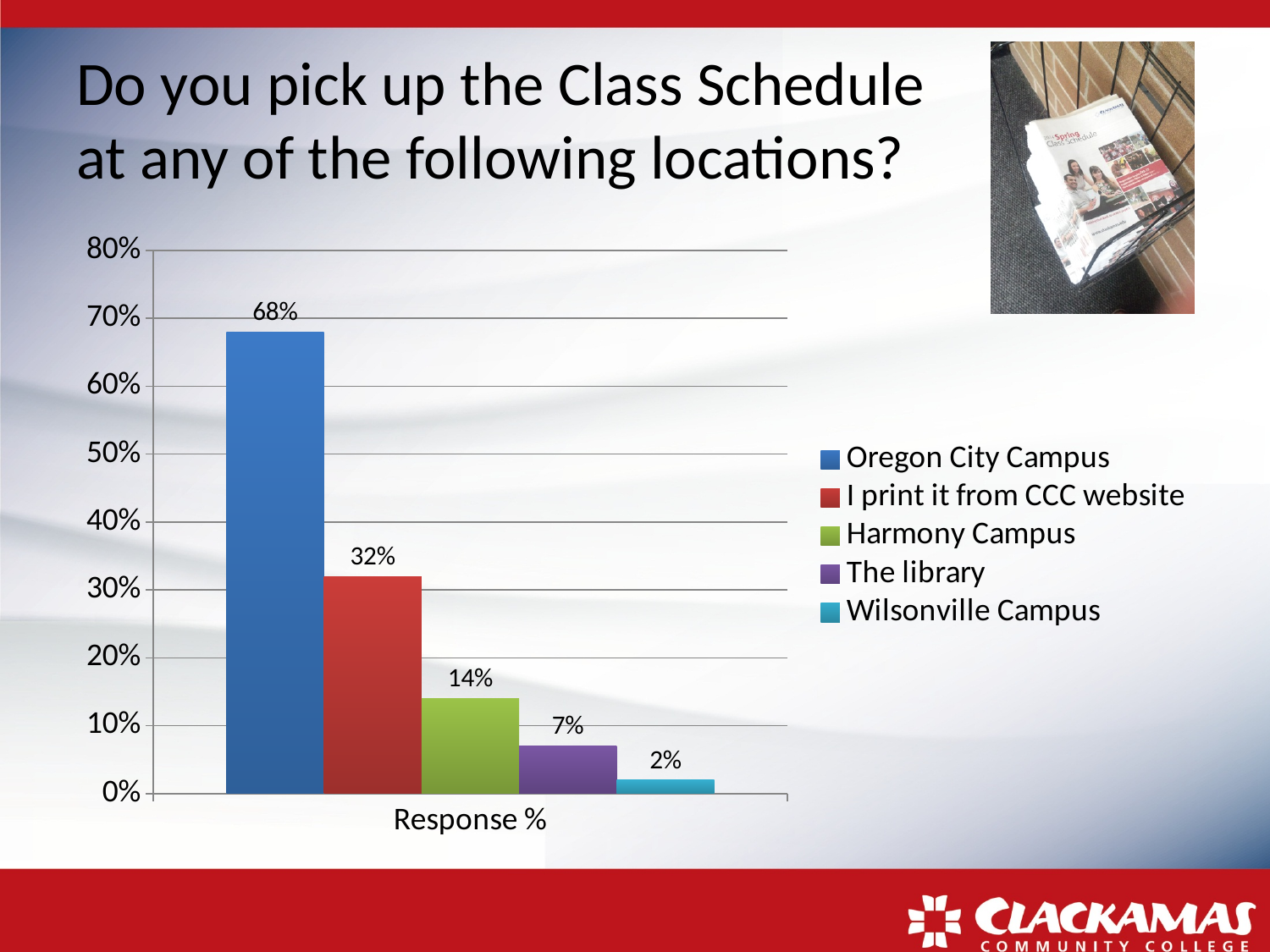
What is the value for Oregon City Campus? 68% What is the value for The library? 7% What is the difference between the values for Oregon City Campus and 'I print it from CCC website'? 36% What is the label on the x axis of the chart? Response % Which location has the highest response percentage? Oregon City Campus What is the value for Harmony Campus? 14% What is the value for Wilsonville Campus? 2% Which is larger, the value for Harmony Campus or the value for The library? Harmony Campus How many series does the legend list? 5 Which location has the lowest response percentage? Wilsonville Campus What is the value for 'I print it from CCC website'? 32% What kind of chart is shown on the slide? Bar chart